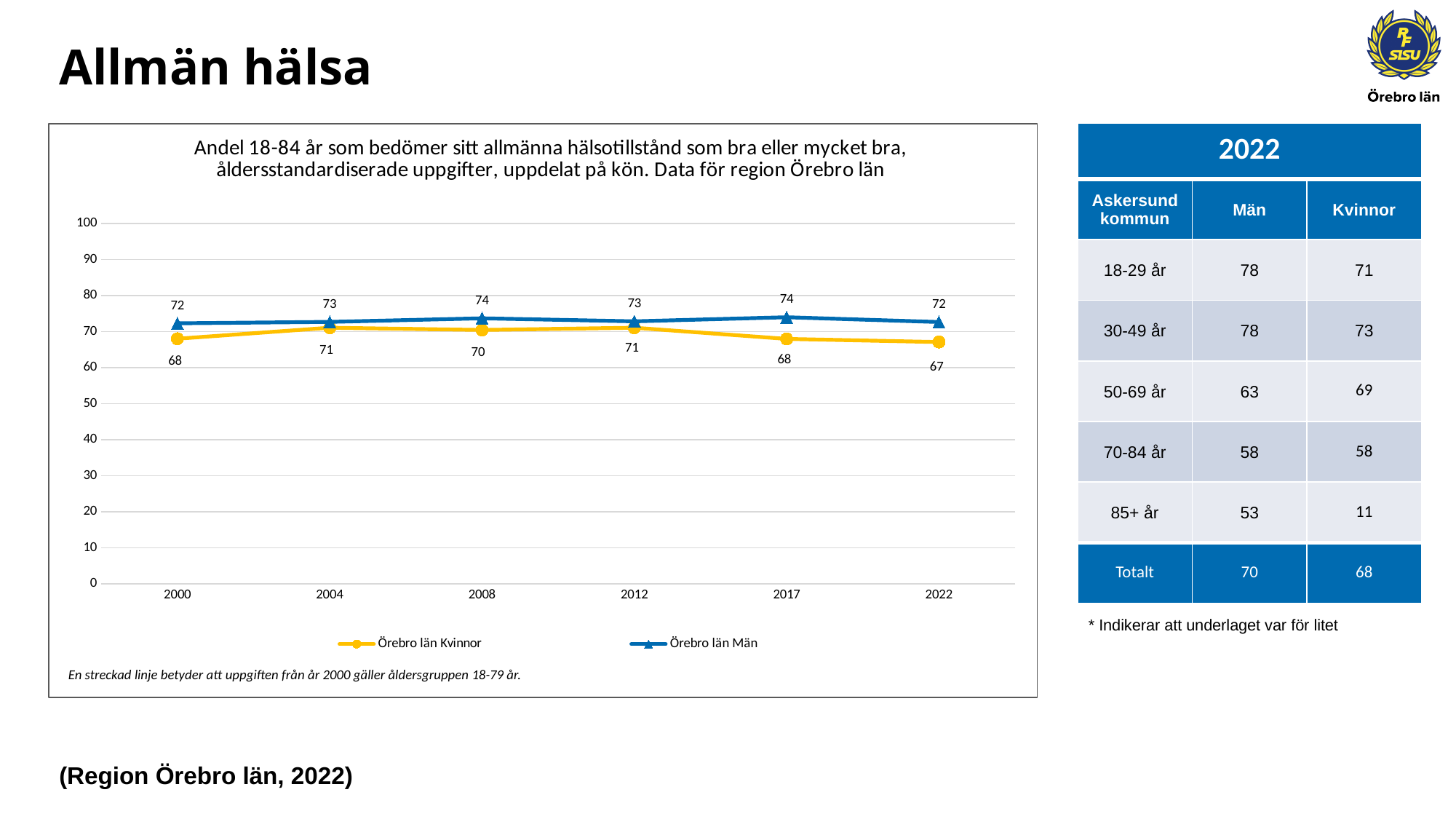
What is the difference between Örebro län Män and Örebro län Kvinnor in 2017? 6 What is the value for Örebro län Män in 2004? 73 What is the value for Örebro län Kvinnor in 2000? 68 What is the difference between Örebro län Män and Örebro län Kvinnor in 2022? 5 How many series does the legend list? 2 What is the value for Örebro län Kvinnor in 2022? 67 Which colour is used for the Örebro län Kvinnor series? yellow How many years are plotted on the x axis? 6 What kind of chart is shown? line chart Which is larger in 2012, the value for Örebro län Män or Örebro län Kvinnor? Örebro län Män In which year is the value for Örebro län Kvinnor lowest? 2022 What is the value for Örebro län Män in 2017? 74